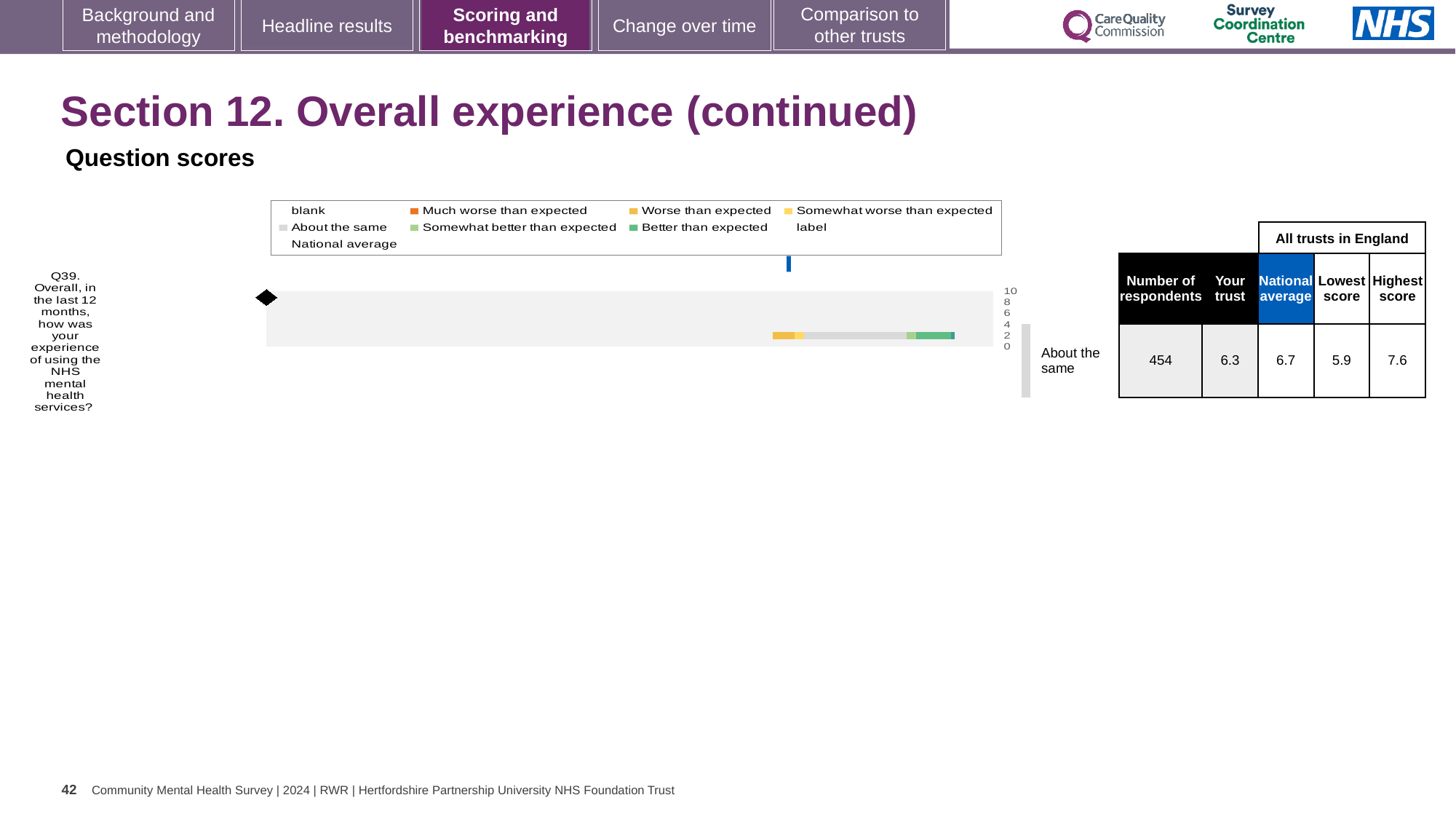
What kind of chart is shown on the slide? bar chart According to the table, how many respondents answered Q39? 454 What is the highest value shown on the chart's score axis? 10 According to the table, what is the highest score among all trusts in England for Q39? 7.6 According to the table, what is the national average score for Q39? 6.7 According to the table, what is the 'Your trust' score for Q39? 6.3 Which question number is plotted in the chart? Q39 Which is larger for Q39, the 'Your trust' score or the national average? National average According to the table, what is the lowest score among all trusts in England for Q39? 5.9 What colour does the legend use for 'Better than expected'? green What is the difference between the highest score and the lowest score for Q39? 1.7 How many survey questions are plotted in the chart? 1